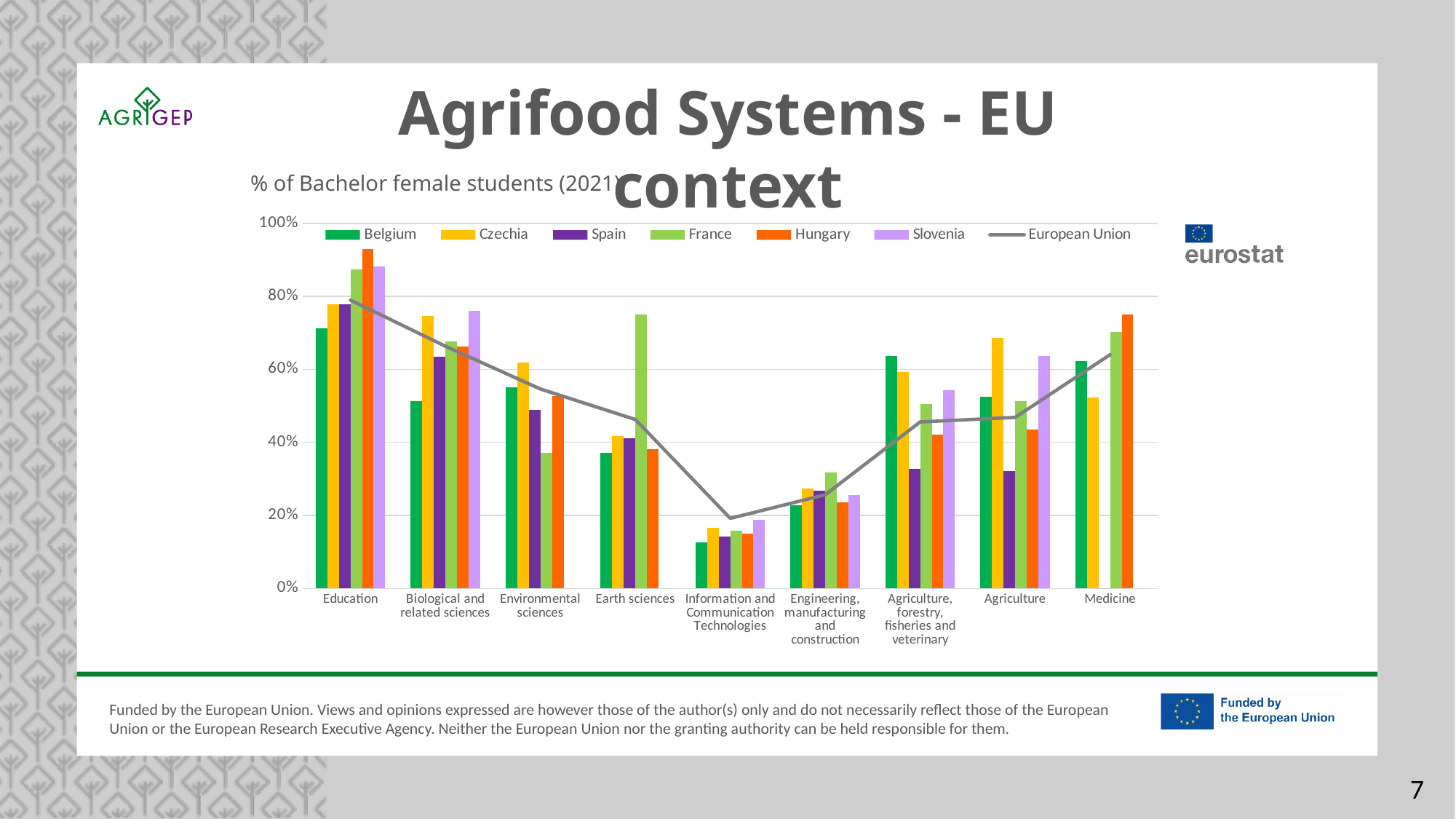
In which category is the European Union line at its lowest? Information and Communication Technologies What kind of chart is shown on the slide? combination bar and line chart Which country has the highest bar in the Education category? Hungary In Medicine, which is larger: the value for Hungary or the value for Czechia? Hungary How many categories are shown along the x axis of the chart? 9 Is the value for Belgium in Information and Communication Technologies greater or less than 20%? less How many series does the chart legend list? 7 Is the value for Hungary in Education greater or less than 80%? greater Which country has the highest bar in the Earth sciences category? France Is the value for France in Earth sciences greater or less than 60%? greater What is the title of the chart? % of Bachelor female students (2021) Which series is drawn as a line rather than bars? European Union